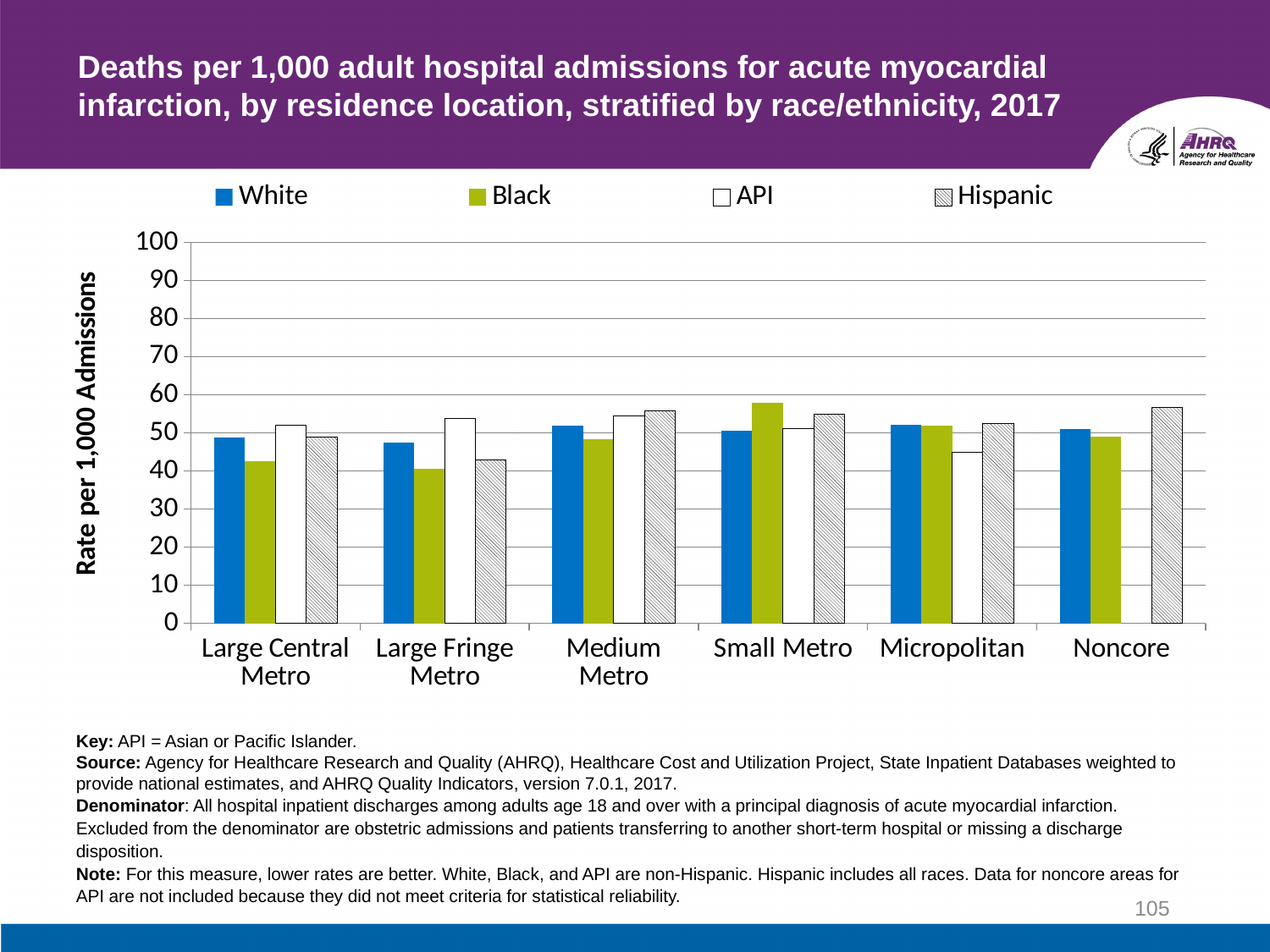
In Large Central Metro, which is larger, the White value or the Black value? White How many series does the legend list? 4 Is the value for Hispanic in Noncore greater or less than 50? greater How many residence location categories are shown on the x axis? 6 Which race/ethnicity group has the highest value in Small Metro? Black Is the value for Black in Large Fringe Metro greater or less than 50? less In Large Fringe Metro, which is larger, the API value or the Hispanic value? API Is the value for Black in Small Metro greater or less than 50? greater What kind of chart is shown on the slide? bar chart Which race/ethnicity group has the lowest value in Large Fringe Metro? Black Which residence location has no API bar plotted? Noncore Which race/ethnicity group has the lowest value in Micropolitan? API